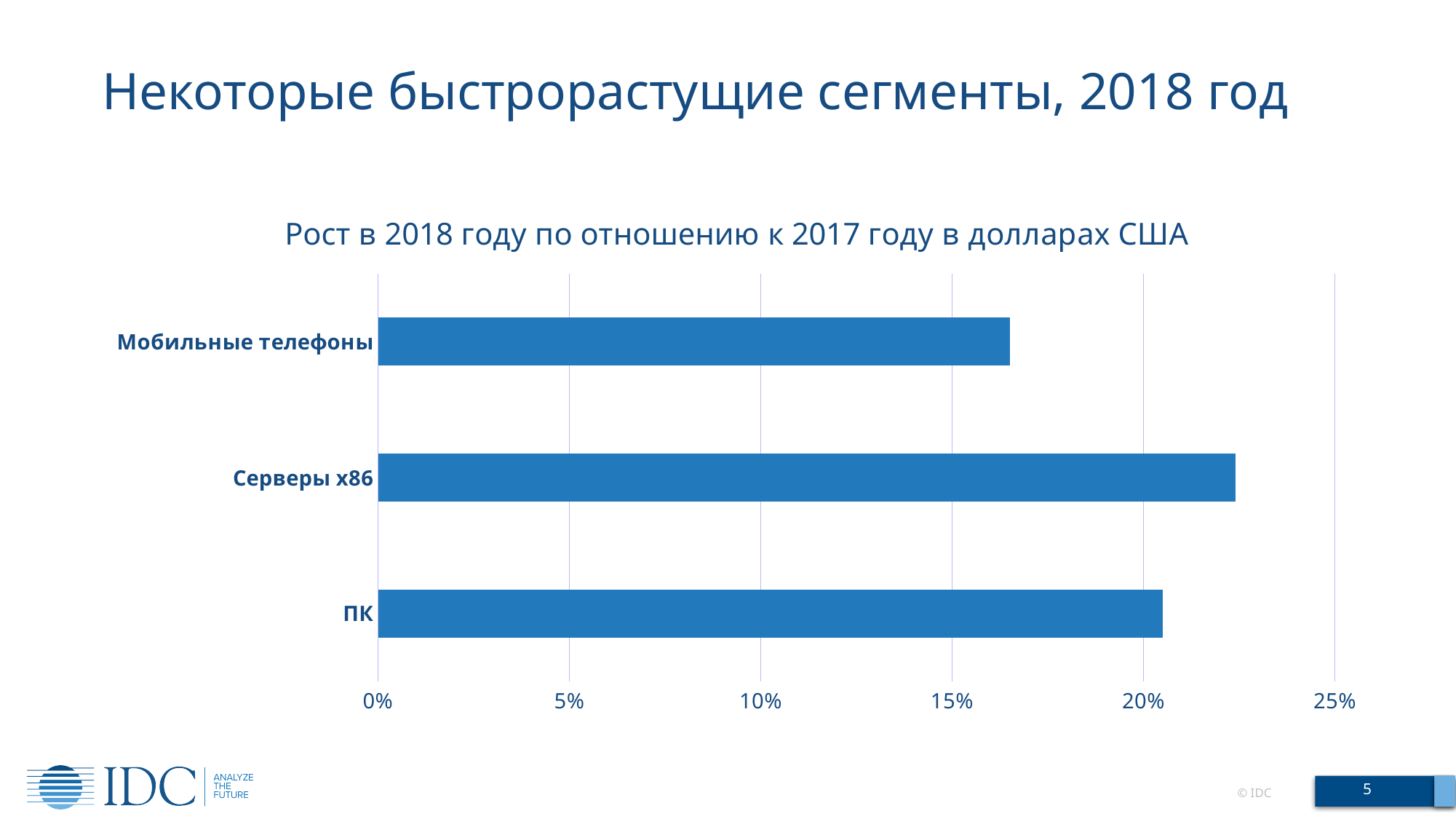
How many segments (categories) are shown in the chart? 3 Which segment has the lowest growth in the chart? Мобильные телефоны Is the value for ПК greater or less than 25%? less Which has the larger value: Серверы x86 or ПК? Серверы x86 What is the highest value shown on the horizontal axis of the chart? 25% What kind of chart is shown on the slide? bar chart Which has the larger value: Мобильные телефоны or ПК? ПК Is the value for Серверы x86 greater or less than 20%? greater Which segment has the highest growth in the chart? Серверы x86 Is the value for Мобильные телефоны greater or less than 15%? greater What is the title of the chart? Рост в 2018 году по отношению к 2017 году в долларах США